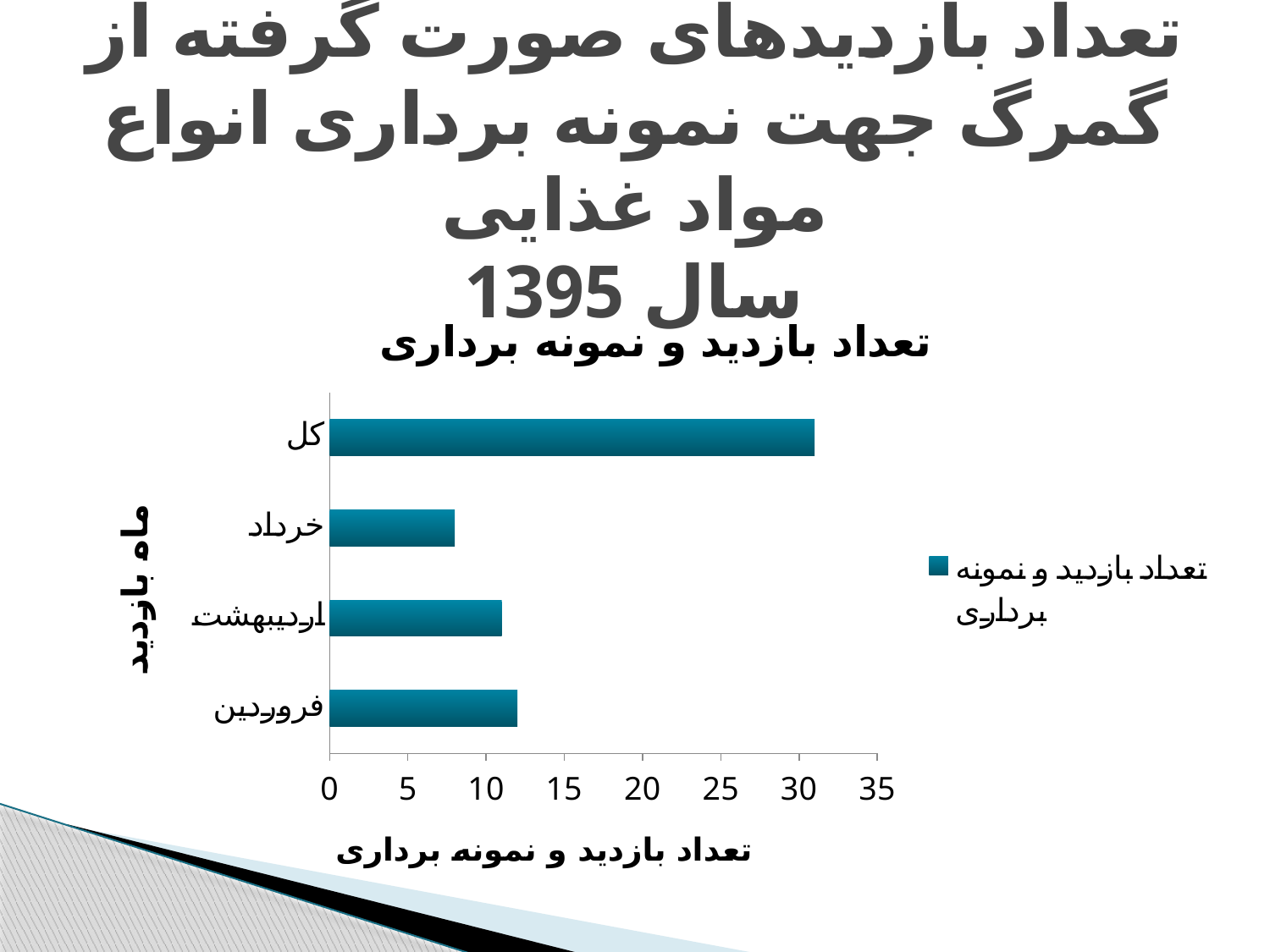
Is the value for خرداد greater or less than 10? less What kind of chart is shown on the slide? bar chart How many series does the chart legend list? 1 Which category has the shortest bar in the chart? خرداد Is the value for کل greater or less than 30? greater Is the value for فروردین greater or less than 10? greater How many categories are plotted on the y axis of the chart? 4 Which category has the longest bar in the chart? کل What is the title of the chart? تعداد بازدید و نمونه برداری Which is larger, the value for فروردین or the value for خرداد? فروردین